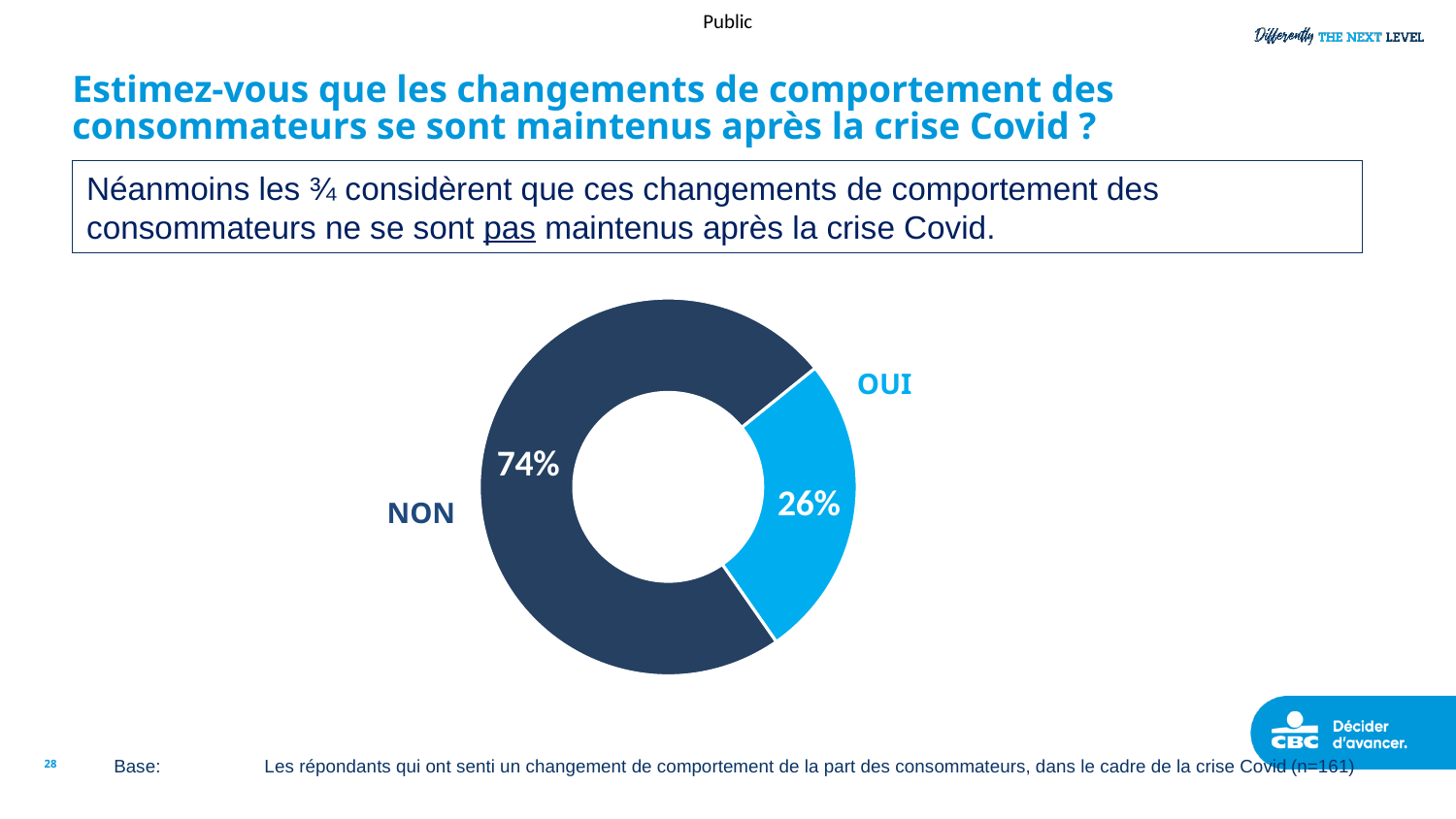
Which response has the largest share of the pie? NON What share of respondents answered OUI? 26% What share of respondents answered NON? 74% What colour is the OUI slice? Light blue What is the total of the two slices shown in the pie chart? 100% What is the sample size (n) given in the base note below the chart? n=161 How many categories does the pie chart show? 2 Which response has the smallest share of the pie? OUI Which is larger, the share for OUI or the share for NON? NON What is the difference in percentage points between the NON and OUI shares? 48 percentage points What kind of chart is shown on the slide? Pie chart (doughnut)